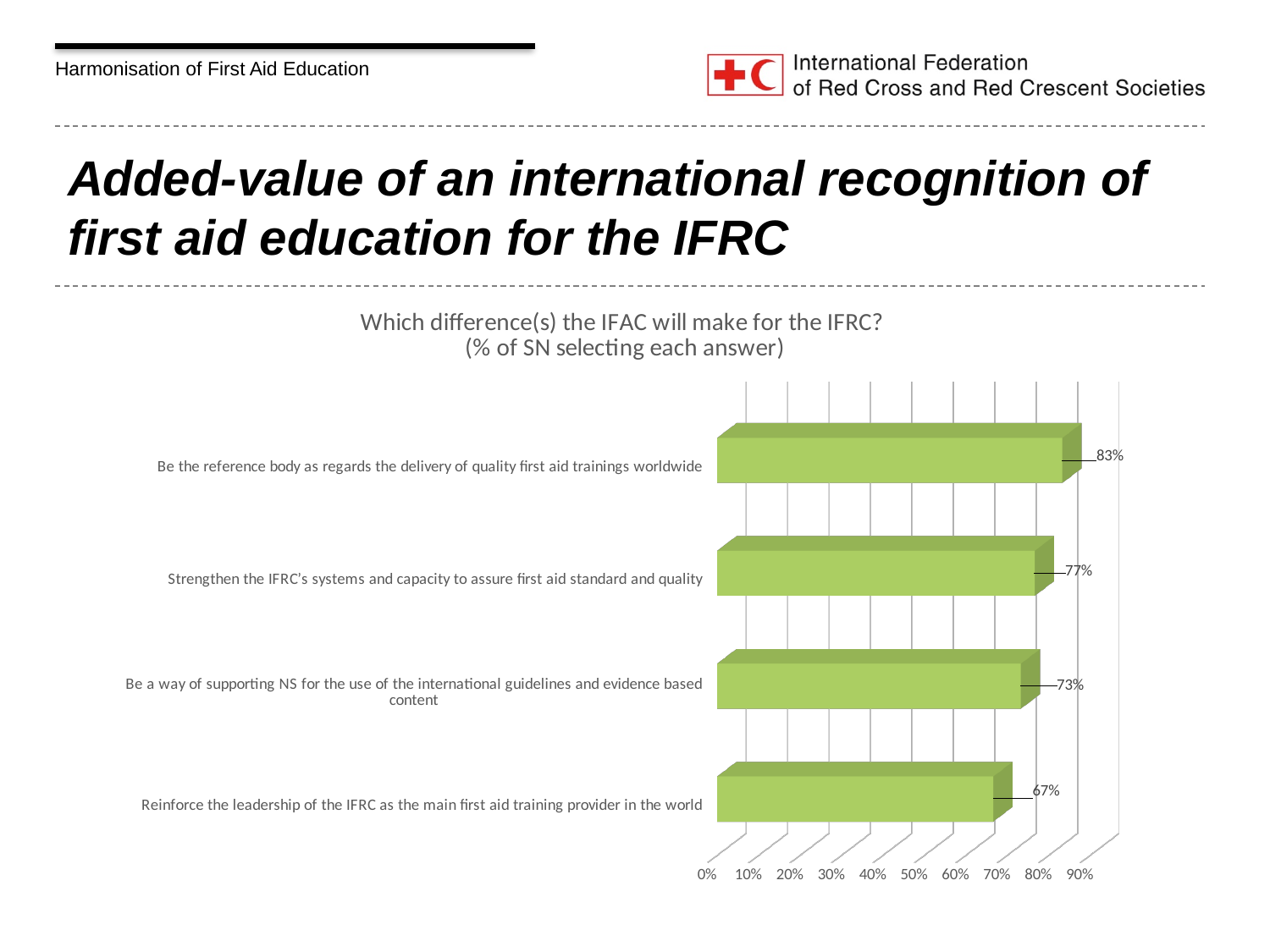
Which is larger: the value for "Be a way of supporting NS for the use of the international guidelines and evidence based content" or for "Reinforce the leadership of the IFRC as the main first aid training provider in the world"? Be a way of supporting NS for the use of the international guidelines and evidence based content Which answer option has the lowest percentage of SN selecting it? Reinforce the leadership of the IFRC as the main first aid training provider in the world What is the difference in percentage points between the highest and lowest bars? 16 What is the difference between "Strengthen the IFRC's systems and capacity to assure first aid standard and quality" and "Be a way of supporting NS for the use of the international guidelines and evidence based content"? 4 percentage points What type of chart is shown on the slide? Bar chart What value is shown for "Strengthen the IFRC's systems and capacity to assure first aid standard and quality"? 77% What is the title of the chart? Which difference(s) the IFAC will make for the IFRC? (% of SN selecting each answer) What percentage of SN selected "Be the reference body as regards the delivery of quality first aid trainings worldwide"? 83% Which answer option has the highest percentage of SN selecting it? Be the reference body as regards the delivery of quality first aid trainings worldwide What percentage is shown for "Reinforce the leadership of the IFRC as the main first aid training provider in the world"? 67% Is the value for "Reinforce the leadership of the IFRC as the main first aid training provider in the world" greater or less than 70%? less How many answer options (bars) are shown in the chart? 4